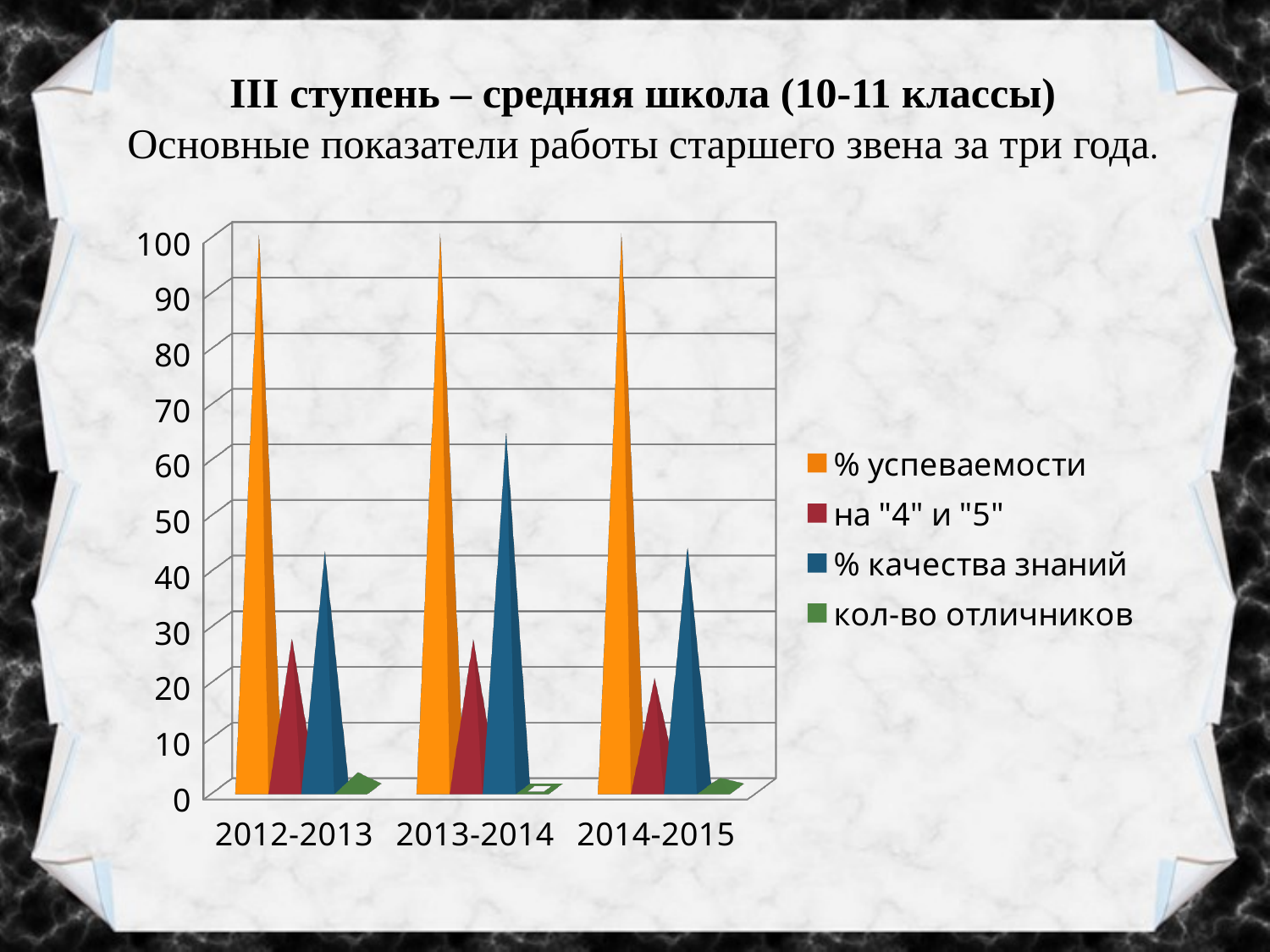
Does the value of на "4" и "5" rise or fall from 2013-2014 to 2014-2015? fall How many series does the legend list? 4 Is the value of кол-во отличников for 2012-2013 greater or less than 10? less Which colour represents кол-во отличников in the legend? green Is the value of % качества знаний for 2013-2014 greater or less than 50? greater In which school year is на "4" и "5" the lowest? 2014-2015 What kind of chart is shown on the slide? bar chart Is the value of % успеваемости for 2014-2015 greater or less than 90? greater In which school year is % качества знаний the highest? 2013-2014 How many school years are shown on the x axis? 3 In 2013-2014, which is larger: % качества знаний or на "4" и "5"? % качества знаний